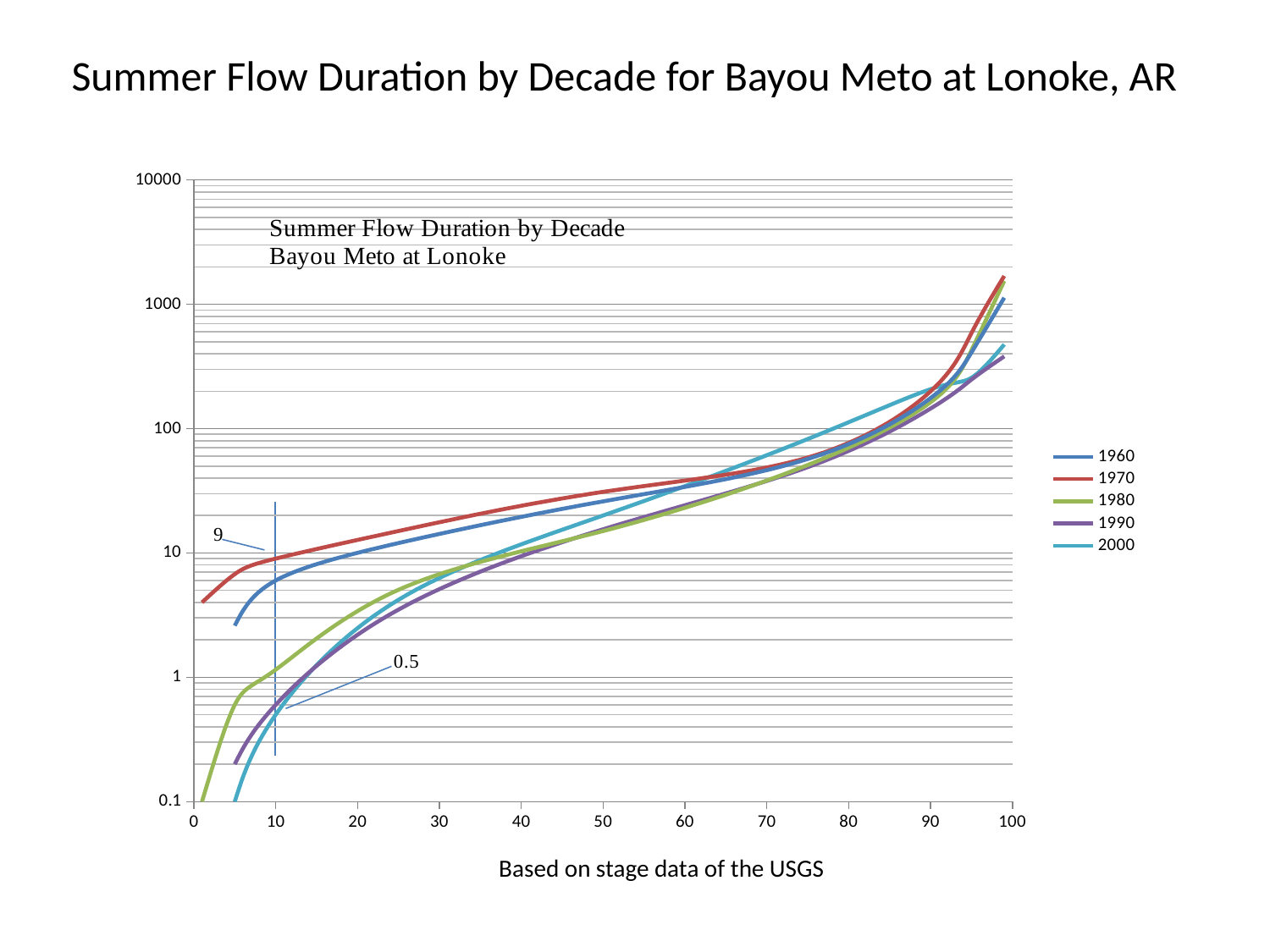
What kind of chart is shown on the slide? line chart At x = 80, which series has the larger value, 2000 or 1980? 2000 How many series does the legend list? 5 What value is annotated on the 2000 line at x = 10? 0.5 Is the value for the 1990 series at x = 100 greater or less than 1000? less At x = 10, which series has the larger value, 1970 or 2000? 1970 Do the values of the 1970 series rise or fall as x increases from 0 to 100? rise Is the value for the 2000 series at x = 10 greater or less than 1? less Which decades are listed in the legend? 1960, 1970, 1980, 1990, 2000 Is the value for the 1970 series at x = 10 greater or less than 1? greater What value is annotated on the 1970 line at x = 10? 9